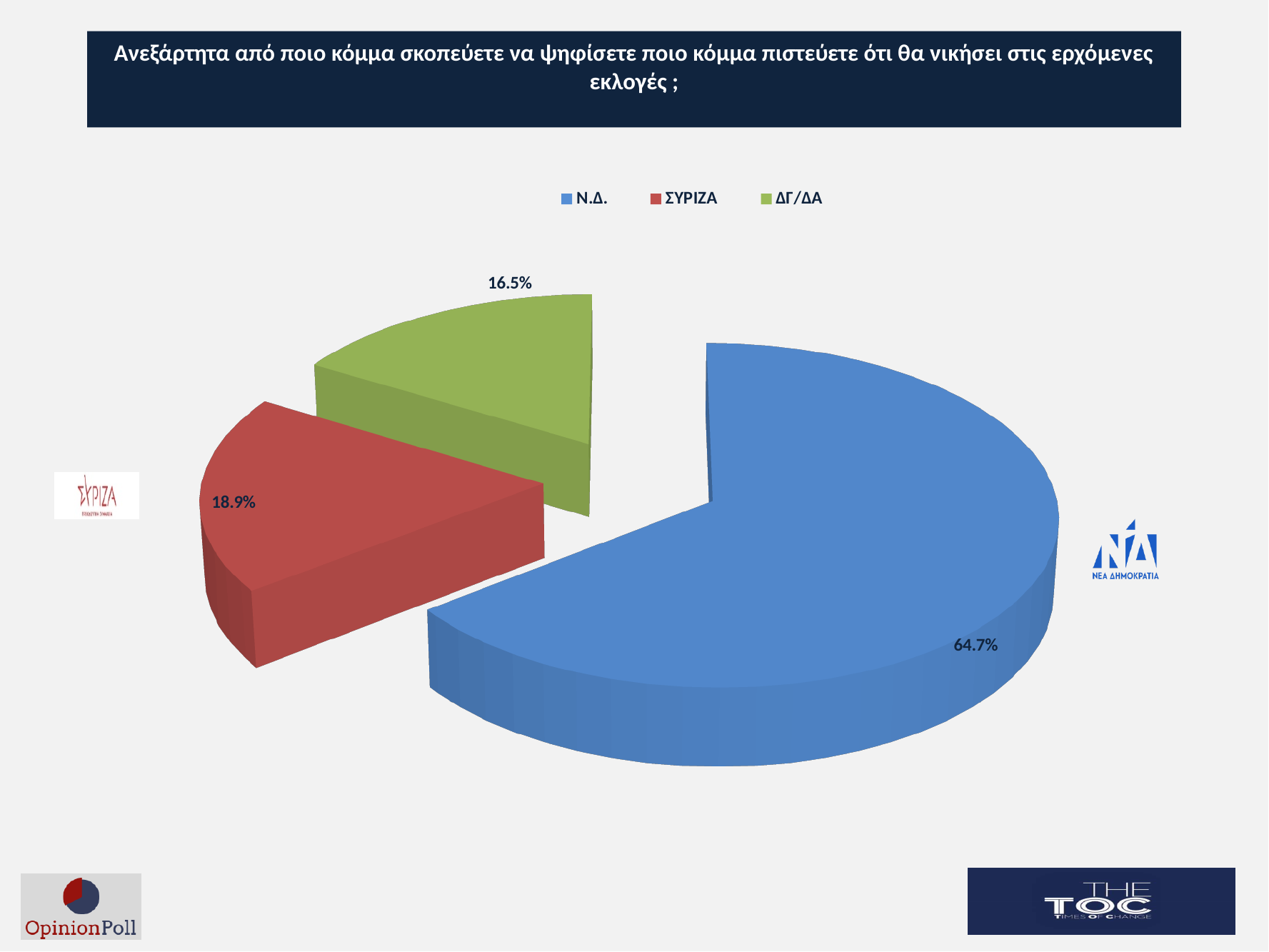
How many slices does the pie chart have? 3 How many entries does the legend list? 3 Which is larger, the slice for ΣΥΡΙΖΑ or the slice for ΔΓ/ΔΑ? ΣΥΡΙΖΑ What percentage of the pie is for ΔΓ/ΔΑ? 16.5% What is the difference in percentage points between Ν.Δ. and ΣΥΡΙΖΑ? 45.8 What percentage of the pie is for Ν.Δ.? 64.7% Which category has the smallest slice of the pie? ΔΓ/ΔΑ What is the difference in percentage points between ΣΥΡΙΖΑ and ΔΓ/ΔΑ? 2.4 What colour is the slice for ΣΥΡΙΖΑ? Red What percentage of the pie is for ΣΥΡΙΖΑ? 18.9% What kind of chart is shown on the slide? Pie chart Which category has the largest slice of the pie? Ν.Δ.